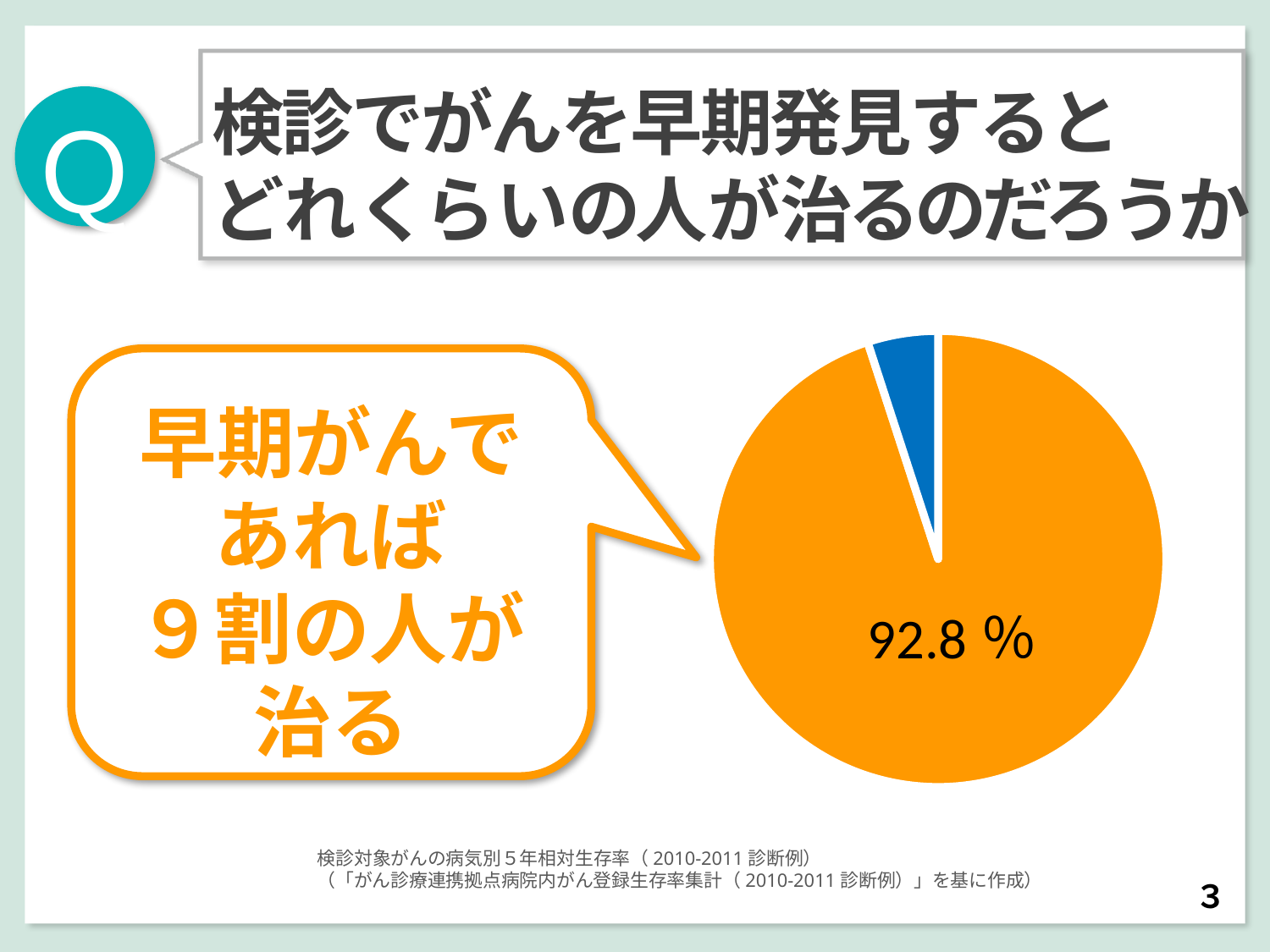
What kind of chart is shown on the slide? pie chart Does the pie chart show a legend? No What share of the pie does the orange slice represent? 92.8 % What value is printed on the large orange slice of the pie chart? 92.8 % What colour is the slice labelled 92.8 % in the pie chart? orange Which slice of the pie chart is the largest? the orange slice How many slices does the pie chart have? 2 Which slice of the pie chart is the smallest? the blue slice Which slice of the pie chart is larger, the orange one or the blue one? the orange one